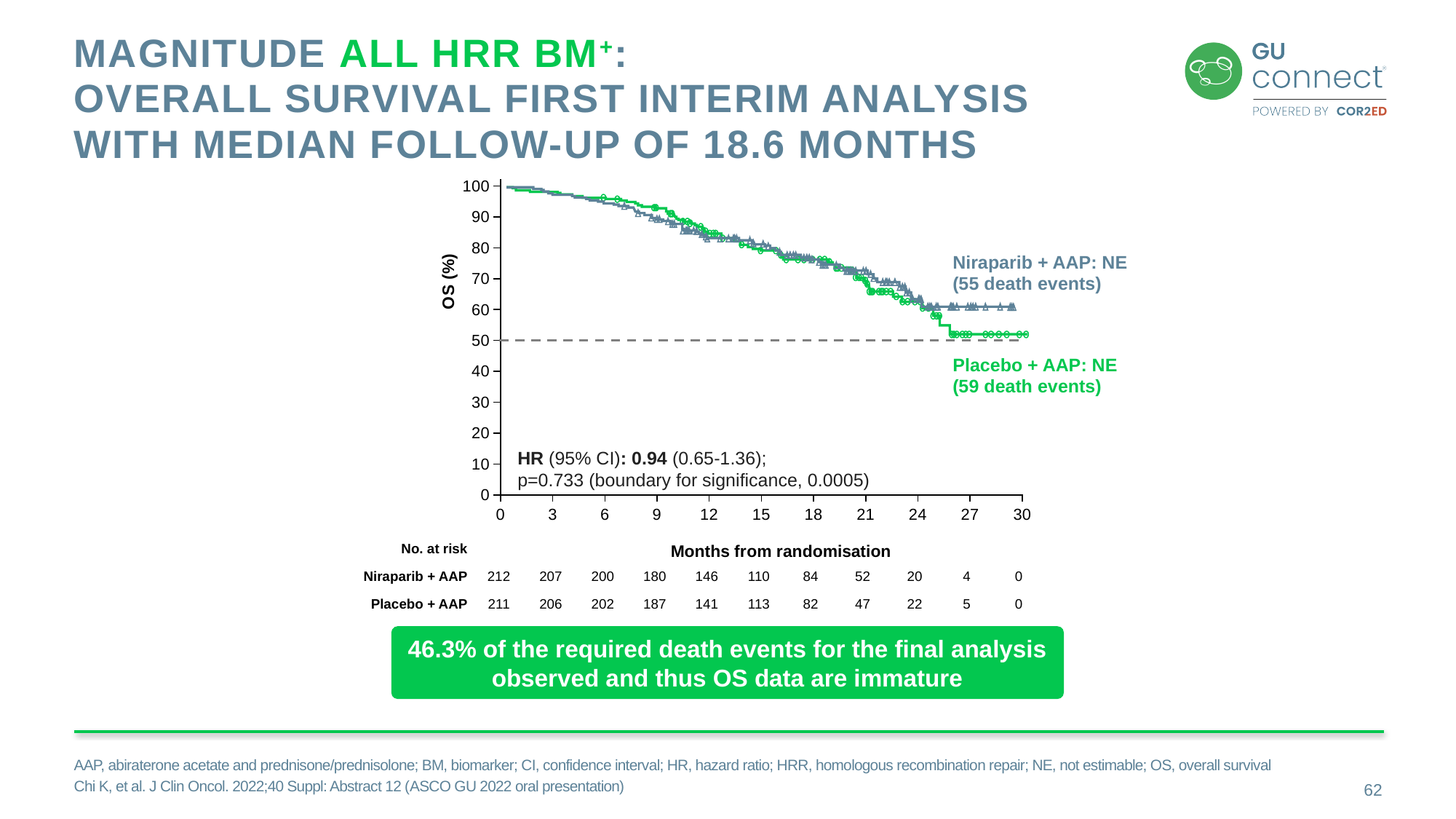
Do the OS (%) curves rise or fall as months from randomisation increase? fall How many death events are reported for the Placebo + AAP arm? 59 Which arm had more death events, Niraparib + AAP or Placebo + AAP? Placebo + AAP What is the 95% confidence interval for the hazard ratio? 0.65-1.36 How many patients were at risk in the Placebo + AAP arm at 12 months? 141 How many death events are reported for the Niraparib + AAP arm? 55 Is the OS (%) value for the Niraparib + AAP curve at 27 months greater or less than 50? greater What is the difference in the number of death events between the Placebo + AAP and Niraparib + AAP arms? 4 How many treatment arms (series) are plotted on the chart? 2 What is the hazard ratio (HR) shown on the chart? 0.94 What is the p-value shown on the chart? 0.733 How many patients were at risk in the Niraparib + AAP arm at 0 months? 212